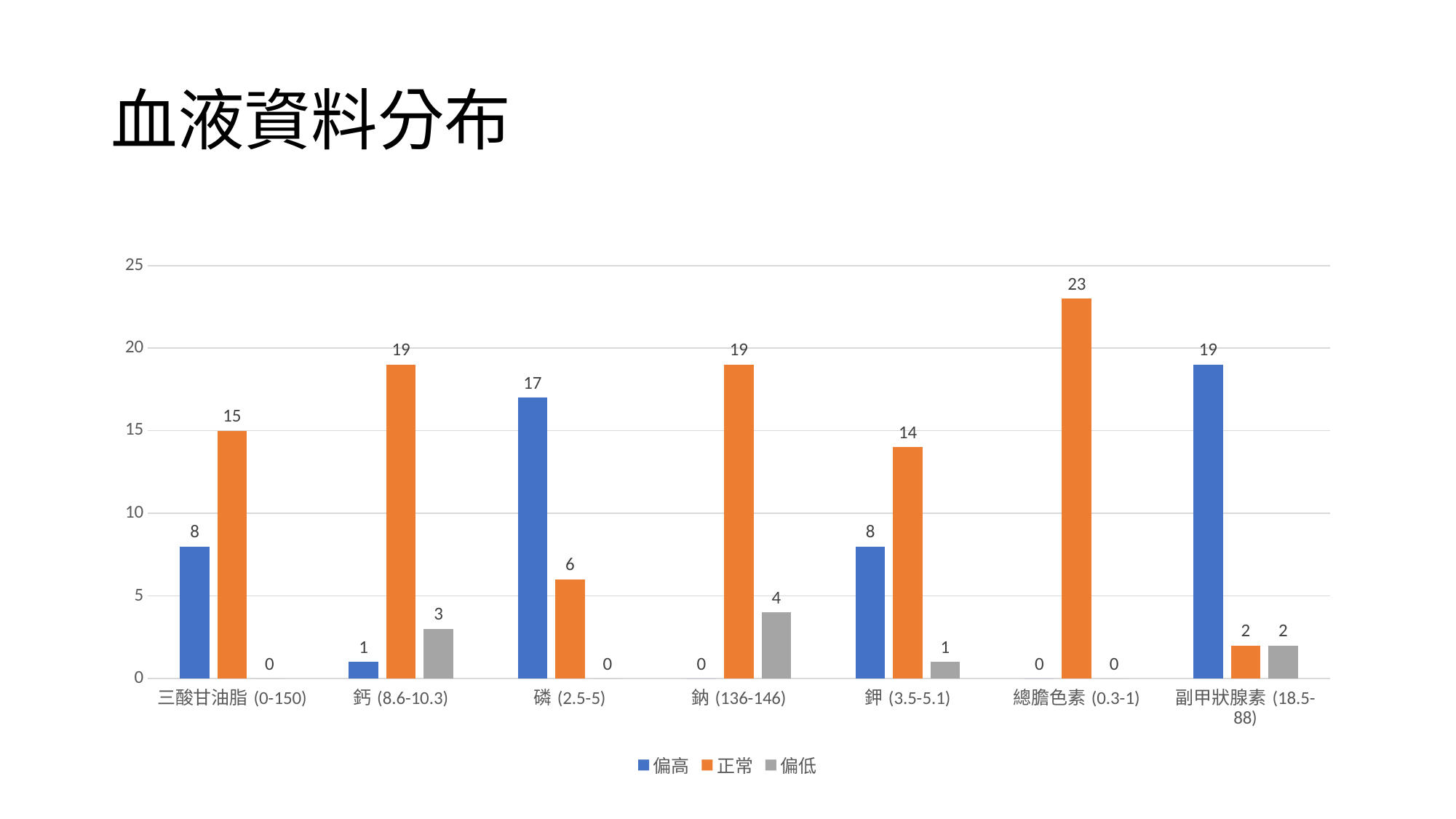
What is the 正常 value for 鈣 (8.6-10.3)? 19 How many series does the legend list? 3 What kind of chart is shown on the slide? bar chart How many categories are shown on the x axis? 7 What is the title of the slide? 血液資料分布 Which category has the highest 偏高 value? 副甲狀腺素 (18.5-88) What is the 偏低 value for 鈉 (136-146)? 4 Which is larger for 鉀 (3.5-5.1): the 偏高 value or the 正常 value? 正常 Which category has the highest 正常 value? 總膽色素 (0.3-1) What is the difference between the 正常 and 偏高 values for 三酸甘油脂 (0-150)? 7 Is the 正常 value for 總膽色素 (0.3-1) greater or less than 20? greater What is the 偏高 value for 磷 (2.5-5)? 17